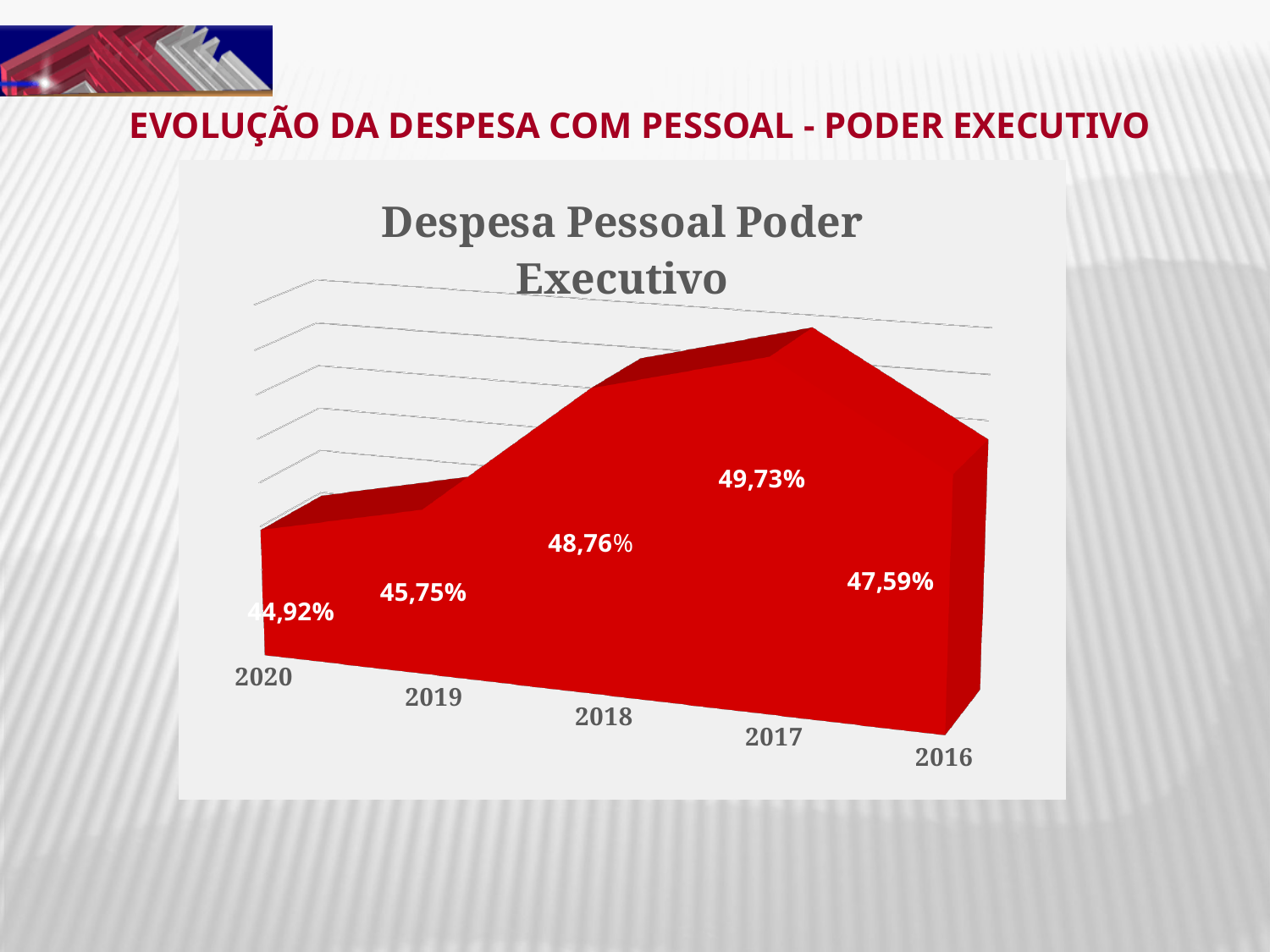
Which year has the lowest value in the Despesa Pessoal Poder Executivo chart? 2020 What is the difference between the values for 2018 and 2019 in the Despesa Pessoal Poder Executivo chart? 3,01 percentage points What kind of chart is the Despesa Pessoal Poder Executivo chart? Area chart What is the value for 2020 in the Despesa Pessoal Poder Executivo chart? 44,92% What is the difference between the values for 2017 and 2016 in the Despesa Pessoal Poder Executivo chart? 2,14 percentage points How many years are shown on the x axis of the Despesa Pessoal Poder Executivo chart? 5 What is the value for 2016 in the Despesa Pessoal Poder Executivo chart? 47,59% Which year has the highest value in the Despesa Pessoal Poder Executivo chart? 2017 What is the value for 2018 in the Despesa Pessoal Poder Executivo chart? 48,76% Do the values rise or fall along the x axis from 2020 to 2017 in the Despesa Pessoal Poder Executivo chart? Rise What is the title of the chart on the slide? Despesa Pessoal Poder Executivo Which is larger in the Despesa Pessoal Poder Executivo chart, the value for 2019 or the value for 2016? 2016